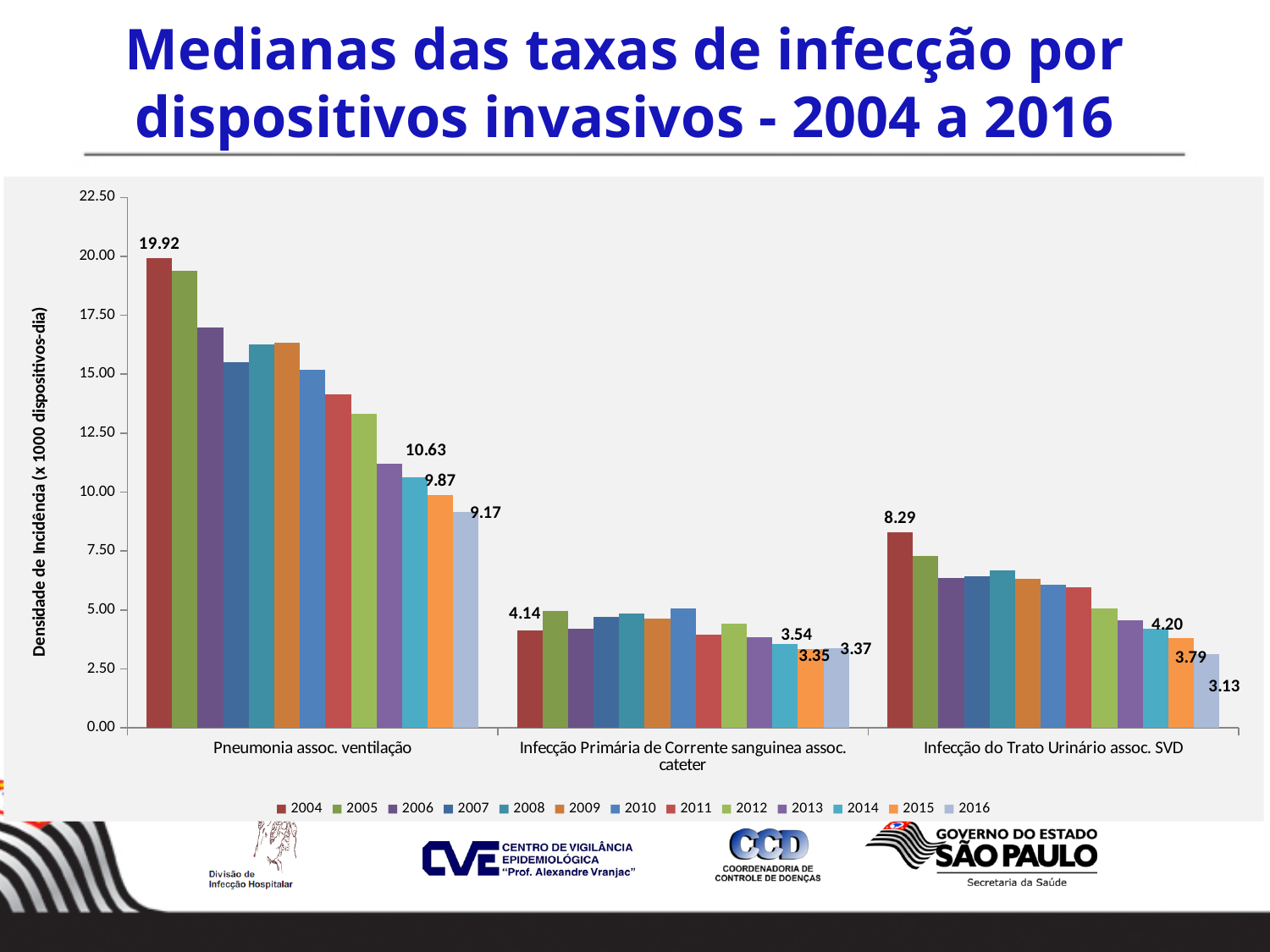
What is the difference between the 2014 and 2015 values in the 'Infecção do Trato Urinário assoc. SVD' category? 0.41 What is the value for 2004 in the 'Pneumonia assoc. ventilação' category? 19.92 How many series does the legend list? 13 What is the label of the y axis? Densidade de Incidência (x 1000 dispositivos-dia) Which category has the highest 2004 value? Pneumonia assoc. ventilação How many categories are shown on the x axis? 3 Is the 2016 value for 'Infecção Primária de Corrente sanguinea assoc. cateter' larger or smaller than the 2016 value for 'Infecção do Trato Urinário assoc. SVD'? larger What is the difference between the 2004 and 2016 values in the 'Pneumonia assoc. ventilação' category? 10.75 What type of chart is shown on the slide? bar chart What is the value for 2015 in the 'Infecção Primária de Corrente sanguinea assoc. cateter' category? 3.35 Is the 2005 value for 'Pneumonia assoc. ventilação' greater or less than 17.50? greater What is the value for 2016 in the 'Infecção do Trato Urinário assoc. SVD' category? 3.13